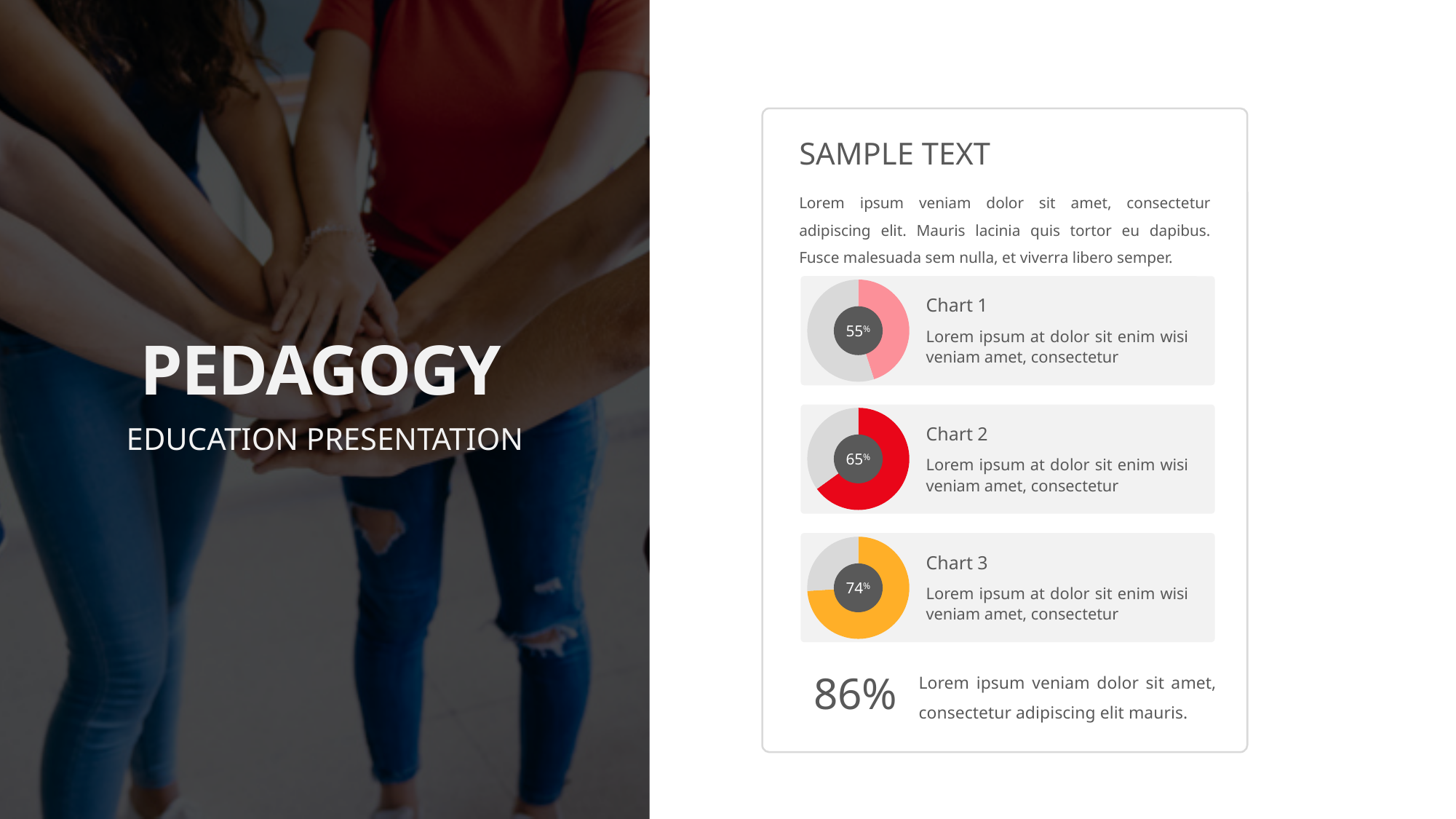
What value is shown in the centre of Chart 3? 74% Which shows a larger percentage, Chart 2 or Chart 3? Chart 3 What colour is the filled portion of Chart 2? Red What is the difference between the percentage in Chart 3 and the percentage in Chart 1? 19% Which of the three donut charts (Chart 1, Chart 2, Chart 3) shows the lowest percentage? Chart 1 What value is shown in the centre of Chart 1? 55% What is the difference between the percentage in Chart 2 and the percentage in Chart 1? 10% What colour is the filled portion of Chart 3? Orange What value is shown in the centre of Chart 2? 65% How many donut charts are shown on the slide? 3 Which of the three donut charts (Chart 1, Chart 2, Chart 3) shows the highest percentage? Chart 3 What kind of chart is Chart 2? Donut chart